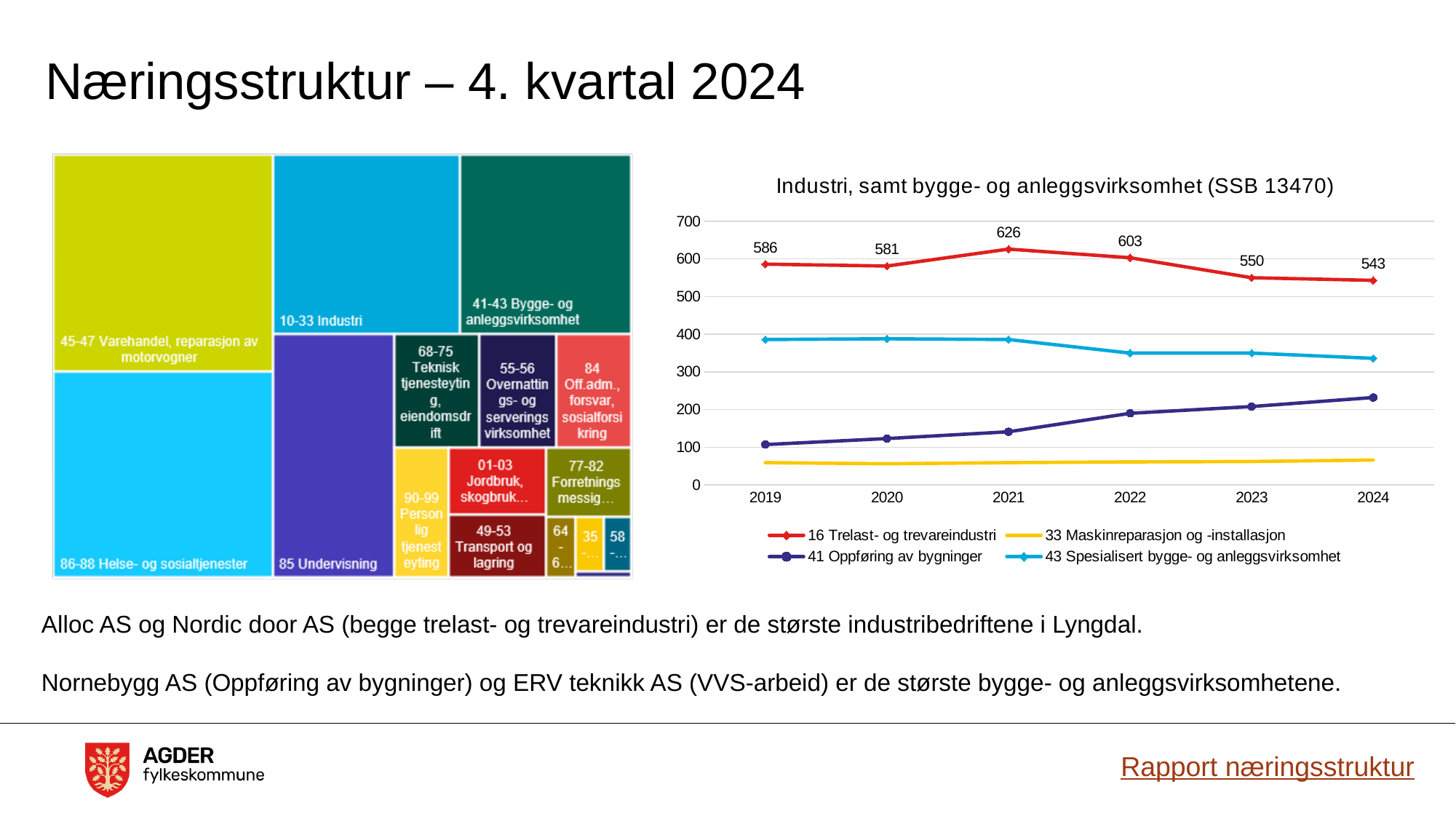
In the chart titled "Industri, samt bygge- og anleggsvirksomhet (SSB 13470)", what is the value for 16 Trelast- og trevareindustri in 2024? 543 How many series does the legend of the line chart on the right list? 4 In the line chart on the right, is the value for 43 Spesialisert bygge- og anleggsvirksomhet in 2019 greater or less than 300? greater In the line chart on the right, which year has the larger value for 16 Trelast- og trevareindustri, 2022 or 2023? 2022 How many years are shown on the x axis of the line chart on the right? 6 What kind of chart is the chart on the right of the slide? line chart In the line chart on the right, in which year is the value for 16 Trelast- og trevareindustri highest? 2021 In the line chart on the right, in which year is the value for 16 Trelast- og trevareindustri lowest? 2024 In the line chart on the right, what is the difference between the 2021 and 2024 values for 16 Trelast- og trevareindustri? 83 In the line chart on the right, is the value for 41 Oppføring av bygninger in 2024 greater or less than 200? greater In the line chart on the right, does the value for 41 Oppføring av bygninger rise or fall from 2019 to 2024? rises In the chart titled "Industri, samt bygge- og anleggsvirksomhet (SSB 13470)", what is the value for 16 Trelast- og trevareindustri in 2021? 626